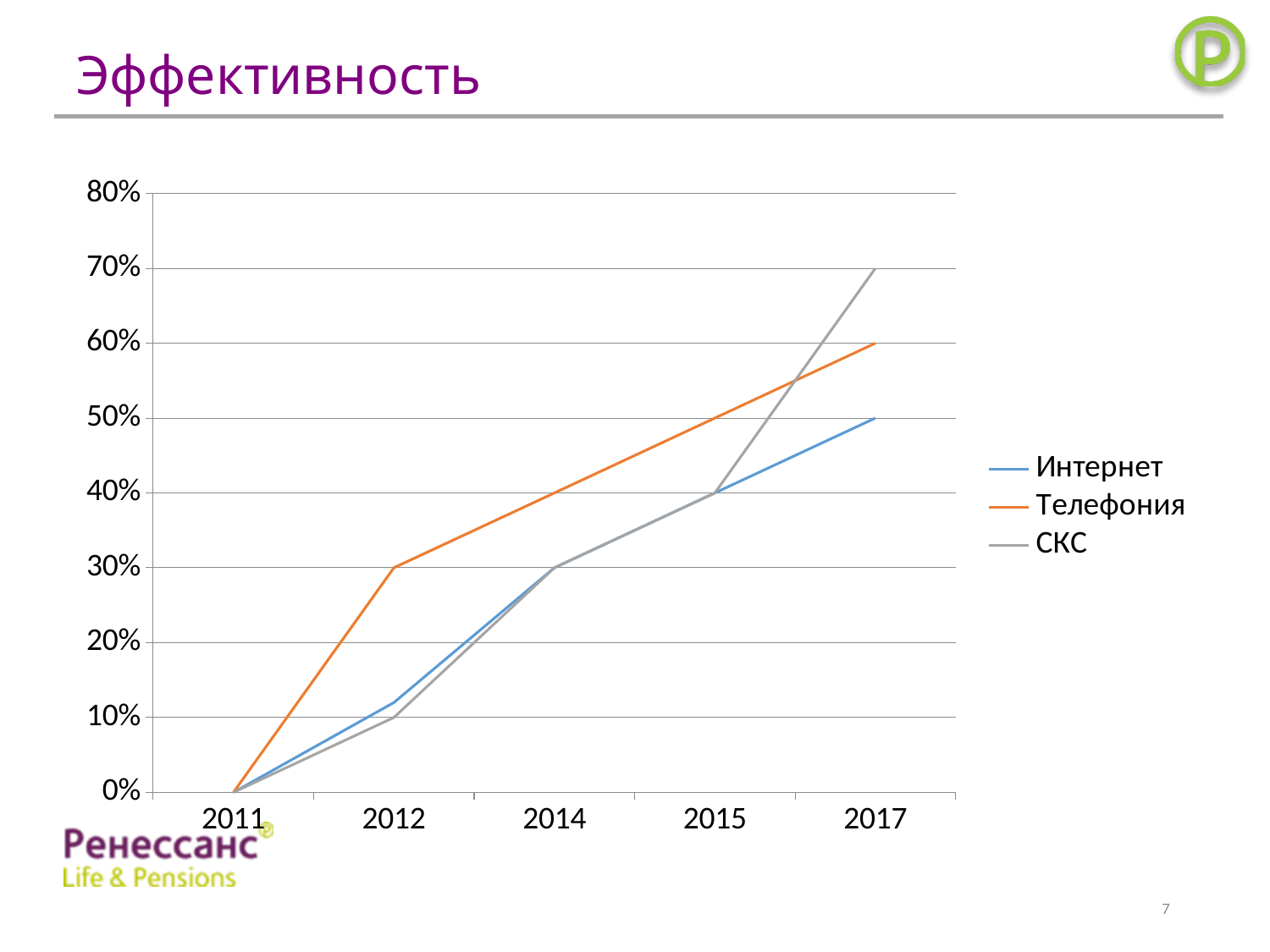
Is the value for Интернет in 2012 greater or less than 20%? less Which series has the highest value in 2017? СКС Which is larger in 2015, the value for Телефония or the value for СКС? Телефония Which series has the highest value in 2012? Телефония What is the value for Телефония in 2017? 60% Which series has the lowest value in 2017? Интернет How many series does the legend list? 3 What is the value for Интернет in 2017? 50% How many years are shown on the x axis? 5 What kind of chart is shown on the slide? line chart What is the value for СКС in 2017? 70% Do the values for Телефония rise or fall from 2011 to 2017? rise